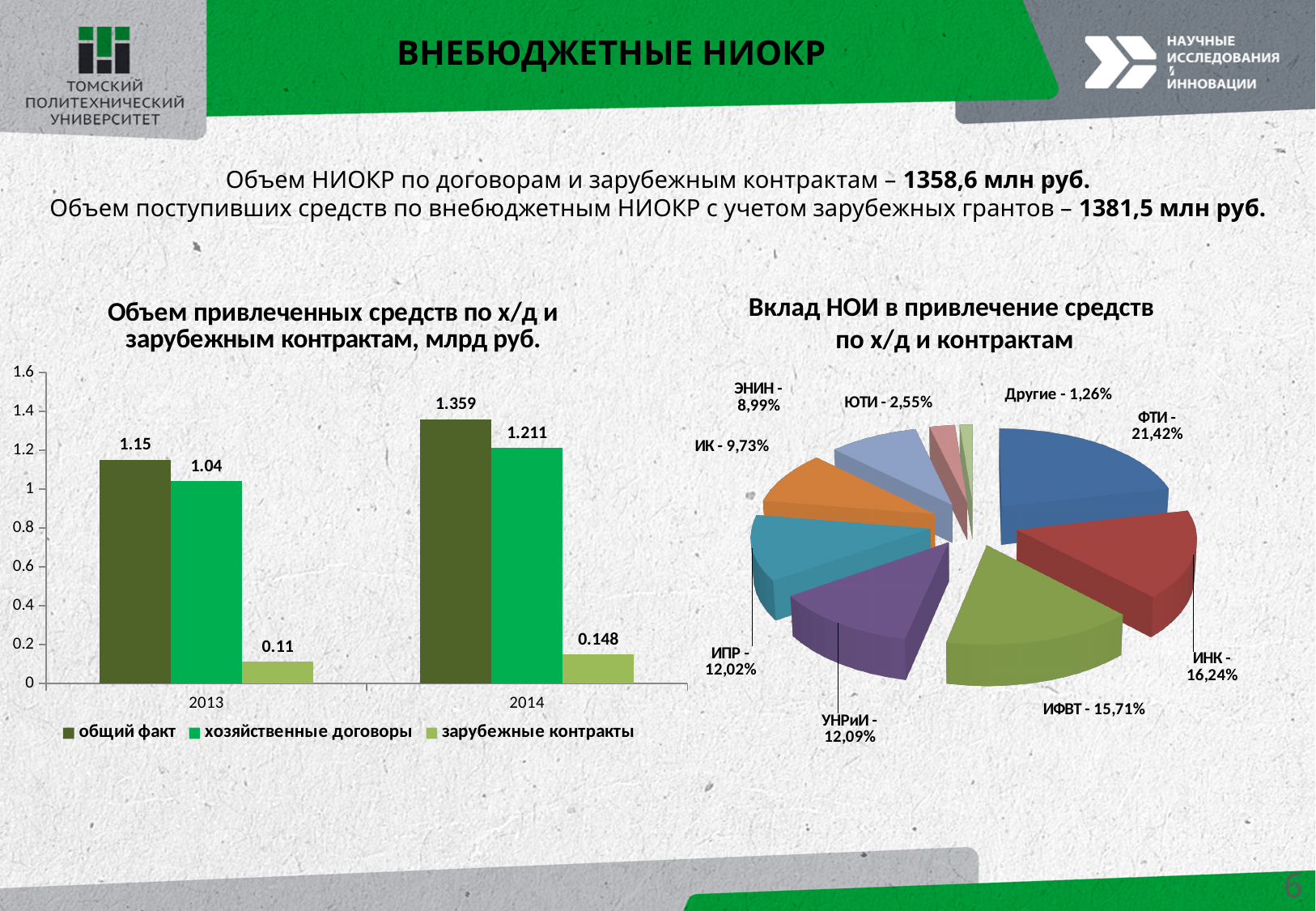
In the pie chart on the right, what is the share of ИНК? 16,24% In the pie chart on the right, which is larger, the share of ИК or the share of ЮТИ? ИК In the bar chart on the left, what is the value for 'зарубежные контракты' in 2013? 0.11 In the pie chart on the right, how many slices are there? 9 In the bar chart on the left, what is the value for 'хозяйственные договоры' in 2014? 1.211 In the pie chart on the right, what is the share of ЭНИН? 8,99% In the pie chart on the right, which institute has the largest share? ФТИ In the bar chart on the left, by how much did 'общий факт' change from 2013 to 2014? 0.209 In the bar chart on the left, what is the value for 'общий факт' in 2014? 1.359 In the bar chart on the left, how many series does the legend list? 3 In the bar chart on the left, does the value for 'хозяйственные договоры' rise or fall from 2013 to 2014? rise What kind of chart is the chart on the left? bar chart